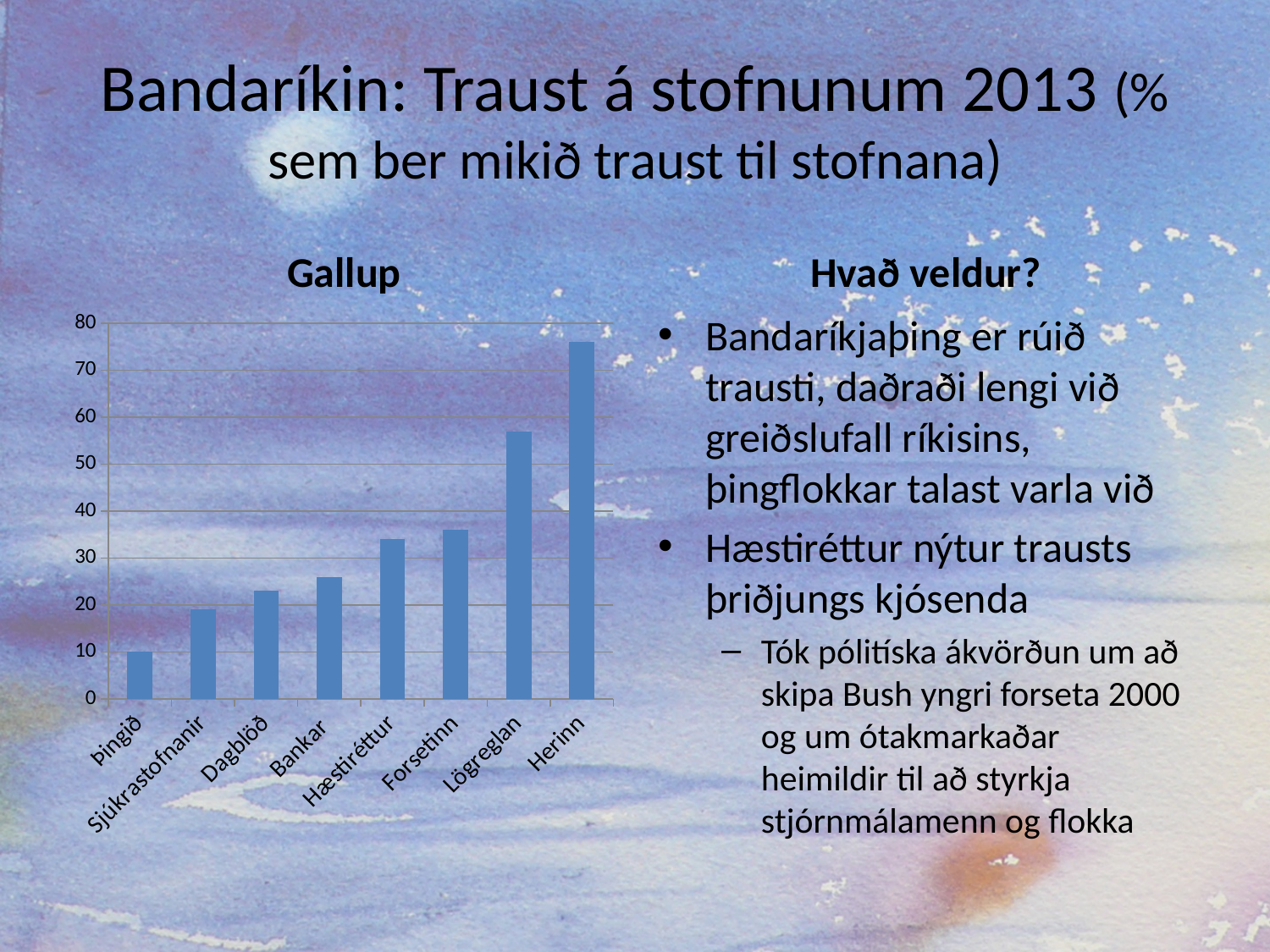
What is the title of the chart? Gallup Do the values rise or fall from left to right along the x axis? rise Which category has the lowest value in the chart? Þingið Which has a larger value, Herinn or Lögreglan? Herinn What kind of chart is shown on the slide? bar chart Is the value for Herinn greater or less than 70? greater Which category has the highest value in the chart? Herinn Is the value for Lögreglan greater or less than 50? greater Which has a larger value, Sjúkrastofnanir or Hæstiréttur? Hæstiréttur Is the value for Bankar greater or less than 30? less How many categories are shown on the x axis of the chart? 8